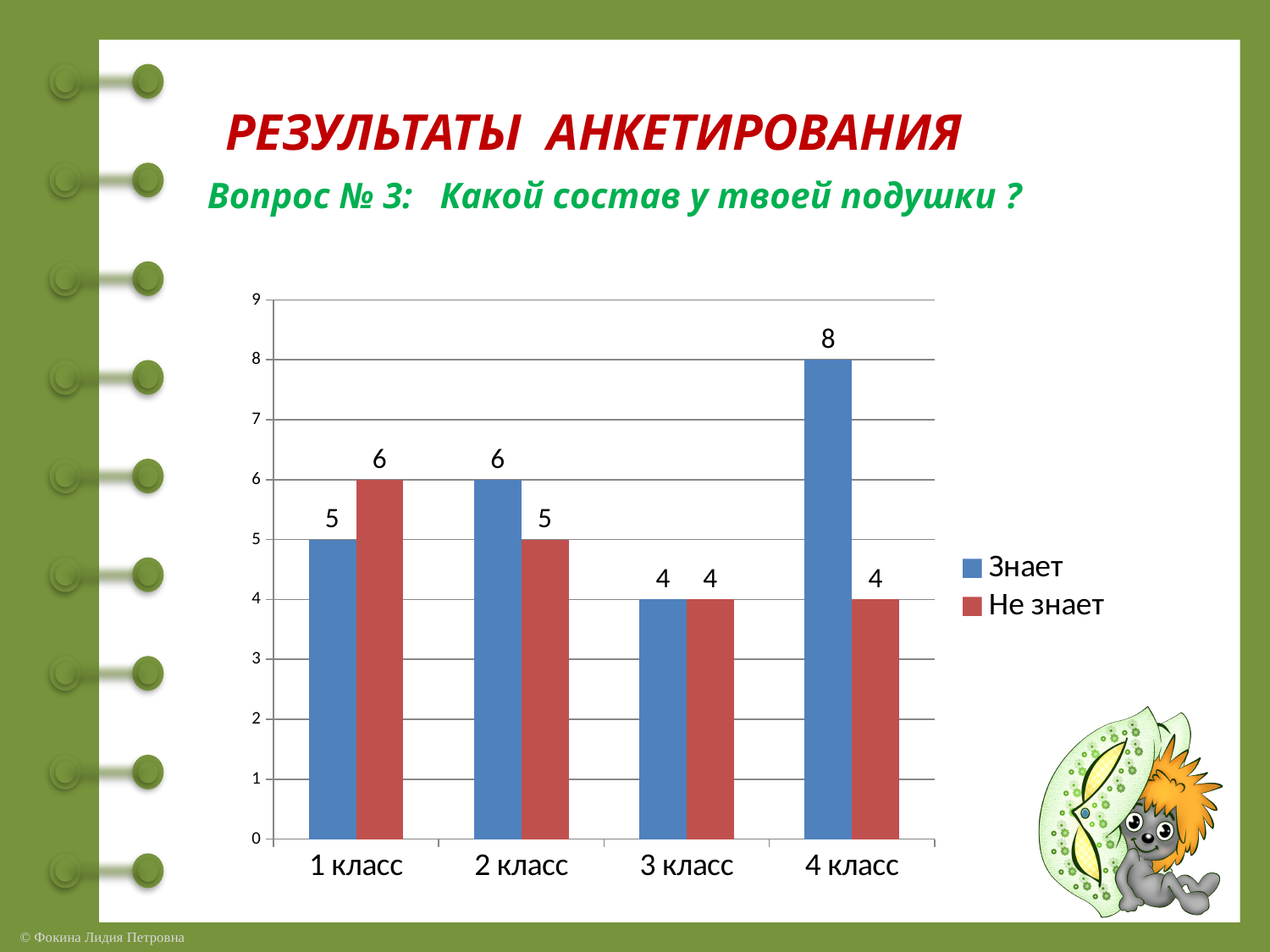
What kind of chart is shown on the slide? Bar chart What is the value for "Знает" in "4 класс"? 8 In "1 класс", which is larger: "Знает" or "Не знает"? Не знает What colour represents the "Не знает" series? Red What is the value for "Не знает" in "3 класс"? 4 What is the difference between "Знает" and "Не знает" in "4 класс"? 4 What is the value for "Не знает" in "1 класс"? 6 How many series does the legend list? 2 Which class has the highest value for "Знает"? 4 класс Which class has the lowest value for "Не знает"? 3 класс and 4 класс (both 4) What is the value for "Знает" in "2 класс"? 6 How many classes are shown on the x axis? 4